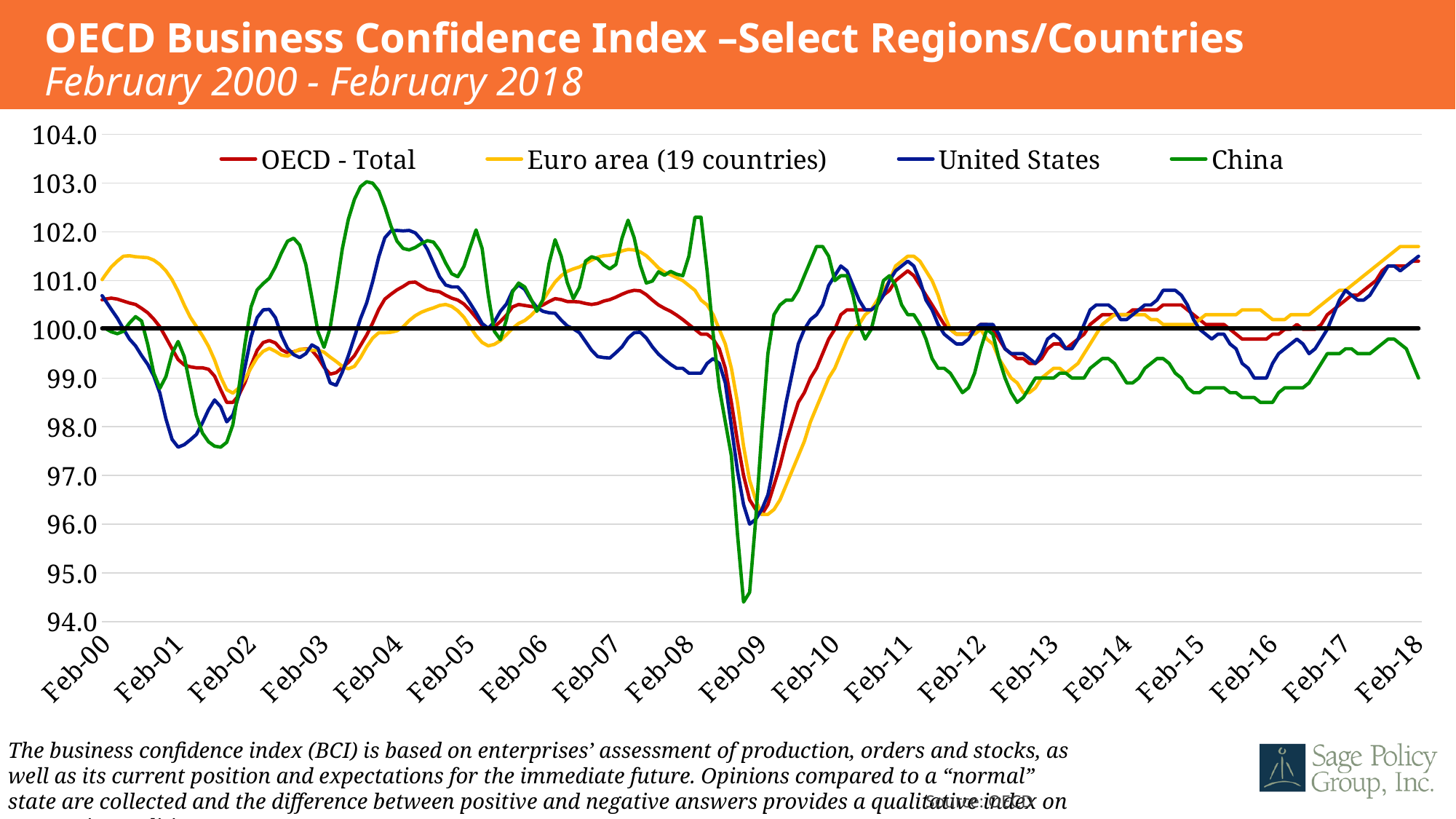
What kind of chart is shown on the slide? Line chart Is the value for the United States at Feb-04 greater or less than 101.0? greater How many series does the legend list? 4 Is the lowest value of the China line greater or less than 95.0? less At Feb-18, which is higher: Euro area (19 countries) or China? Euro area (19 countries) Is the value for OECD - Total at Feb-09 greater or less than 97.0? less Which series reaches the highest value on the chart? China What value does the thick horizontal black line mark on the y axis? 100.0 Which series reaches the lowest value on the chart? China How many labelled points are there on the x axis (from Feb-00 to Feb-18)? 19 Does the Euro area (19 countries) line rise or fall between Feb-16 and Feb-18? rise